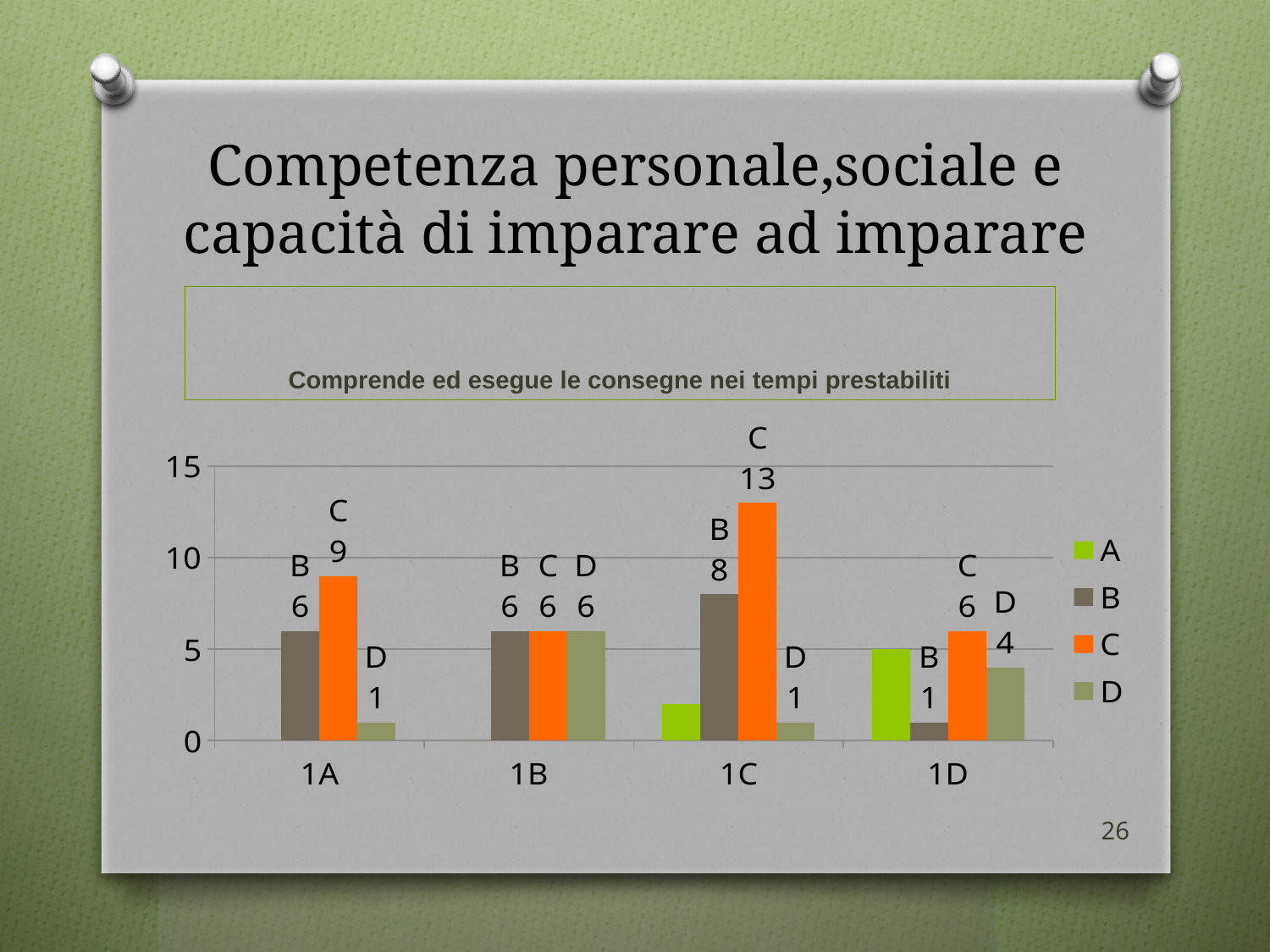
What is the value for series D in category 1D? 4 Is the value for series A in category 1C greater or less than 5? less What is the value for series B in category 1D? 1 Which category has the lowest value for series B? 1D How many categories are shown on the x axis? 4 How many series does the legend list? 4 What is the value for series C in category 1C? 13 What kind of chart is shown on the slide? bar chart Which category has the highest value for series C? 1C Which is larger in category 1A: the value for series C or the value for series D? C What is the value for series B in category 1A? 6 What is the difference between the values for series C and series B in category 1C? 5